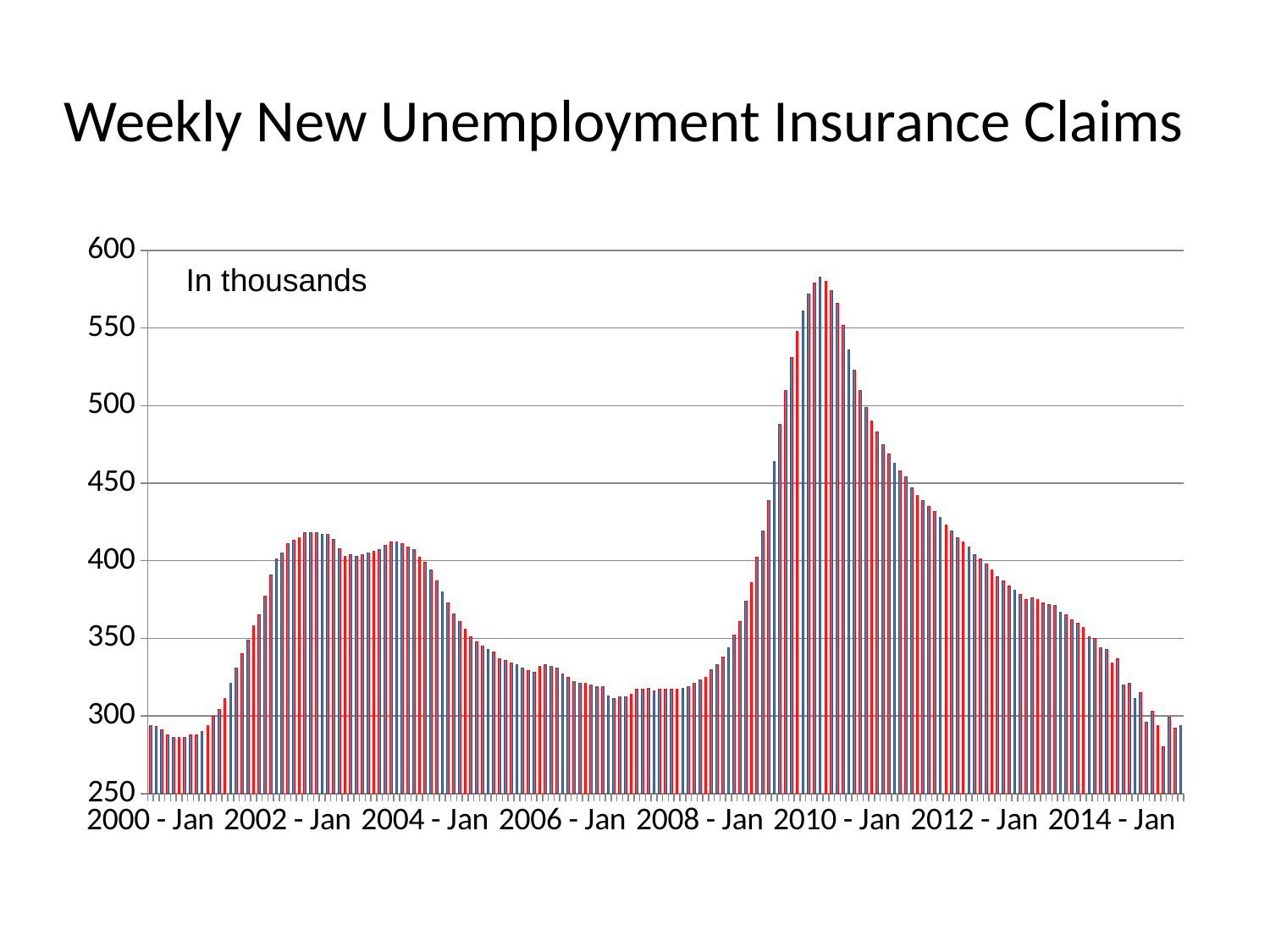
Is the value at 2006 - Jan greater or less than 350? less Is the value at 2000 - Jan greater or less than 300? less What kind of chart is shown on the slide? bar chart What is the title of the chart? Weekly New Unemployment Insurance Claims Is the value at 2008 - Jan greater or less than 350? less Do the values rise or fall between 2010 - Jan and 2014 - Jan? fall Which is larger, the value at 2010 - Jan or the value at 2002 - Jan? 2010 - Jan Around which labelled year on the x axis do the claims reach their highest level? 2010 - Jan In what units are the values on the chart expressed, according to the note inside the plot area? In thousands Do the values rise or fall between 2008 - Jan and 2010 - Jan? rise